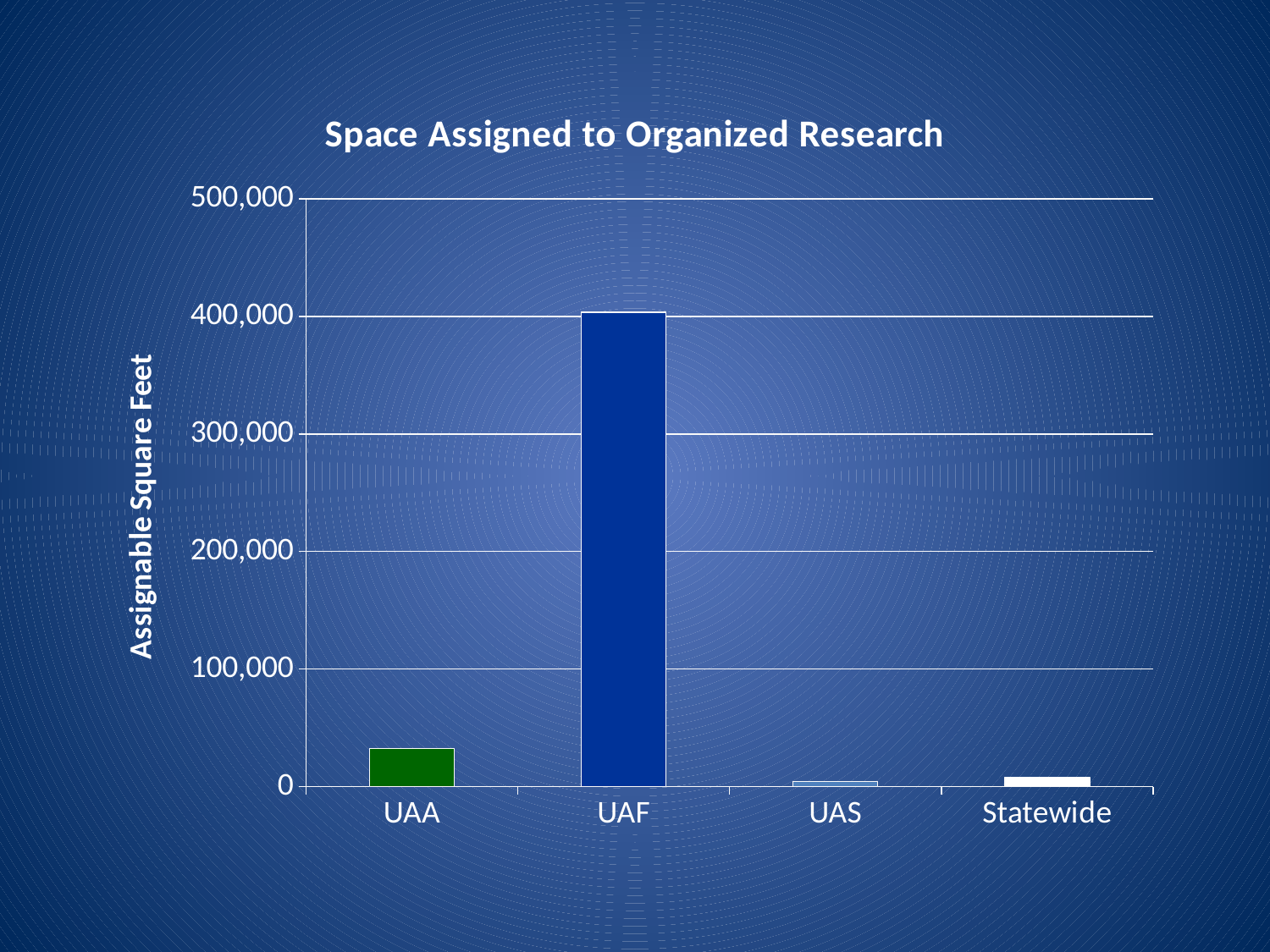
What kind of chart is shown on the slide? bar chart How many categories are shown on the x axis of the chart? 4 Which is larger, the value for UAA or the value for Statewide? UAA Which is larger, the value for UAA or the value for UAS? UAA Is the value for UAA greater or less than 100,000? less What is the label on the vertical axis of the chart? Assignable Square Feet Is the value for UAS greater or less than 100,000? less Is the value for UAF greater or less than 300,000? greater What is the title of the chart? Space Assigned to Organized Research Which category has the highest assignable square feet? UAF Which is larger, the value for UAA or the value for UAF? UAF